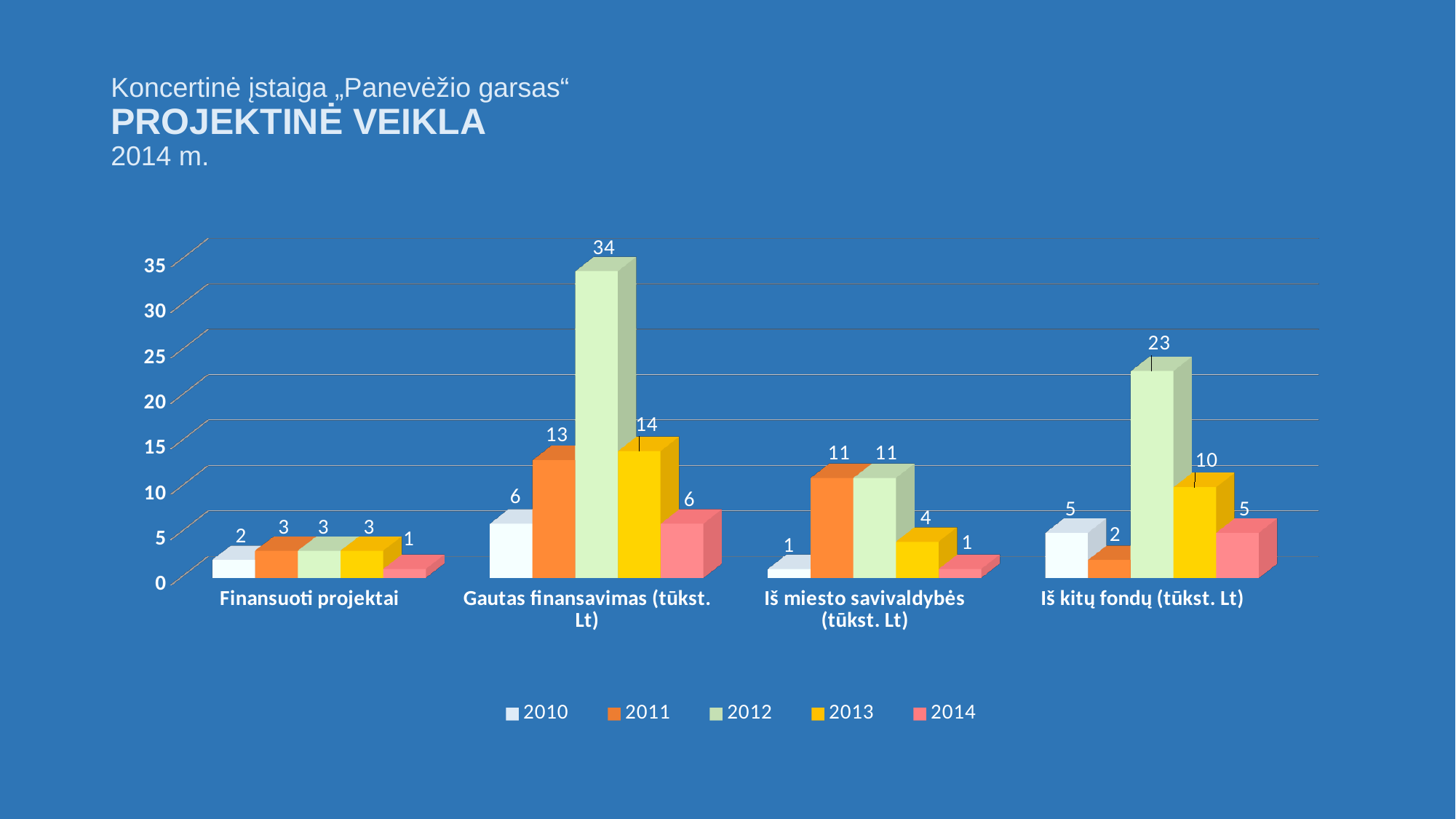
How many series does the legend list? 5 In the "Iš kitų fondų (tūkst. Lt)" category, which is larger: the value for 2010 or the value for 2011? 2010 Is the value for 2012 in the "Iš kitų fondų (tūkst. Lt)" category greater or less than 20? greater What is the value for 2012 in the "Gautas finansavimas (tūkst. Lt)" category? 34 What is the value for 2013 in the "Iš kitų fondų (tūkst. Lt)" category? 10 Which year has the highest value in the "Iš kitų fondų (tūkst. Lt)" category? 2012 What is the value for 2010 in the "Finansuoti projektai" category? 2 How many categories are shown on the x axis of the chart? 4 Which year has the lowest value in the "Finansuoti projektai" category? 2014 What is the value for 2011 in the "Iš miesto savivaldybės (tūkst. Lt)" category? 11 What kind of chart is shown on the slide? Bar chart What is the difference between the 2012 and 2013 values in the "Gautas finansavimas (tūkst. Lt)" category? 20